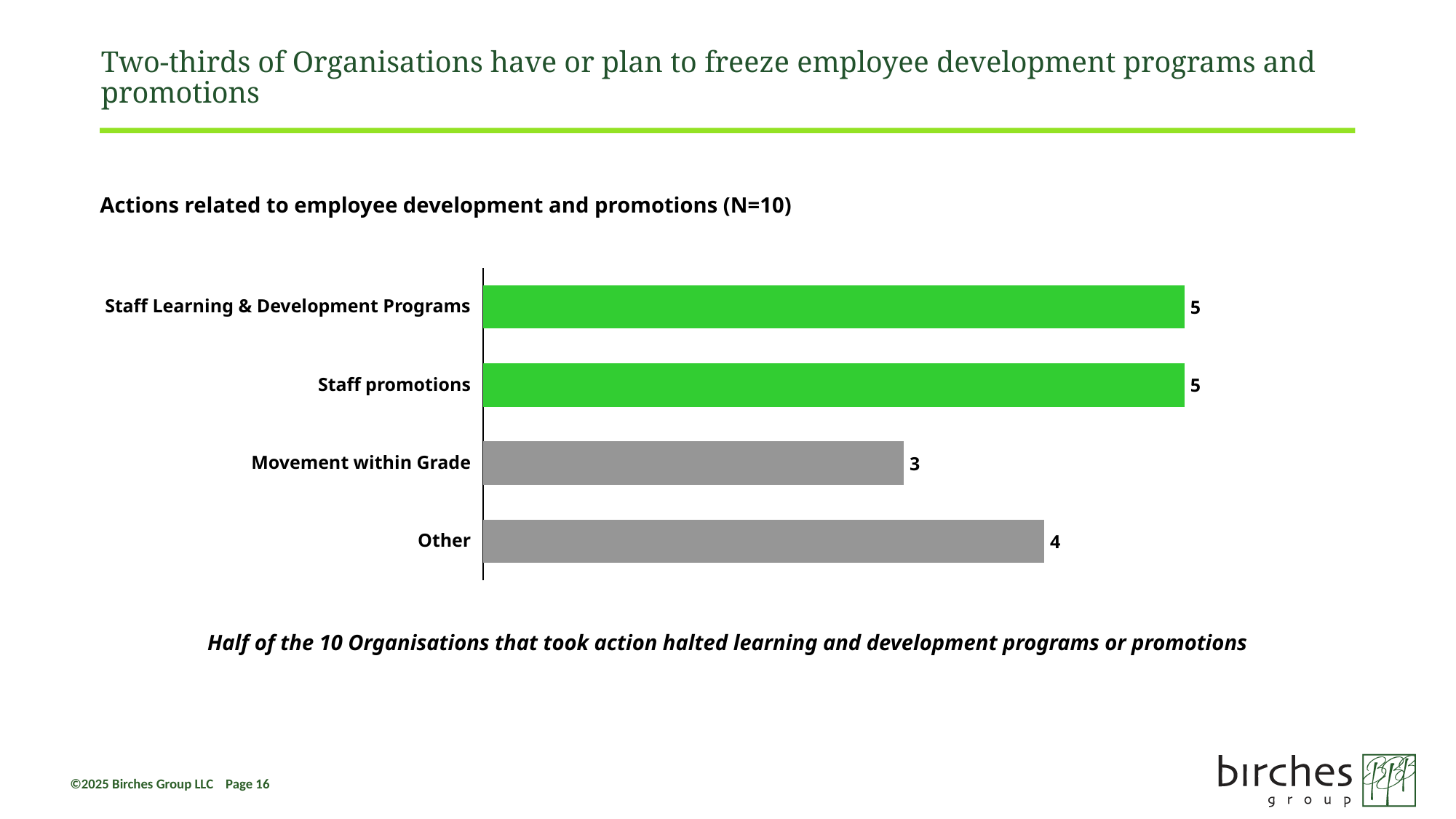
Which is larger, the value for Staff promotions or the value for Other? Staff promotions What is the difference between the values for Staff promotions and Movement within Grade? 2 What is the title of the chart? Actions related to employee development and promotions (N=10) What is the value for Movement within Grade? 3 What is the difference between the values for Other and Movement within Grade? 1 What is the value for Staff promotions? 5 Which is larger, the value for Other or the value for Movement within Grade? Other How many categories are shown in the chart? 4 What kind of chart is shown on the slide? Bar chart What is the value for Other? 4 What is the value for Staff Learning & Development Programs? 5 Which category has the lowest value? Movement within Grade